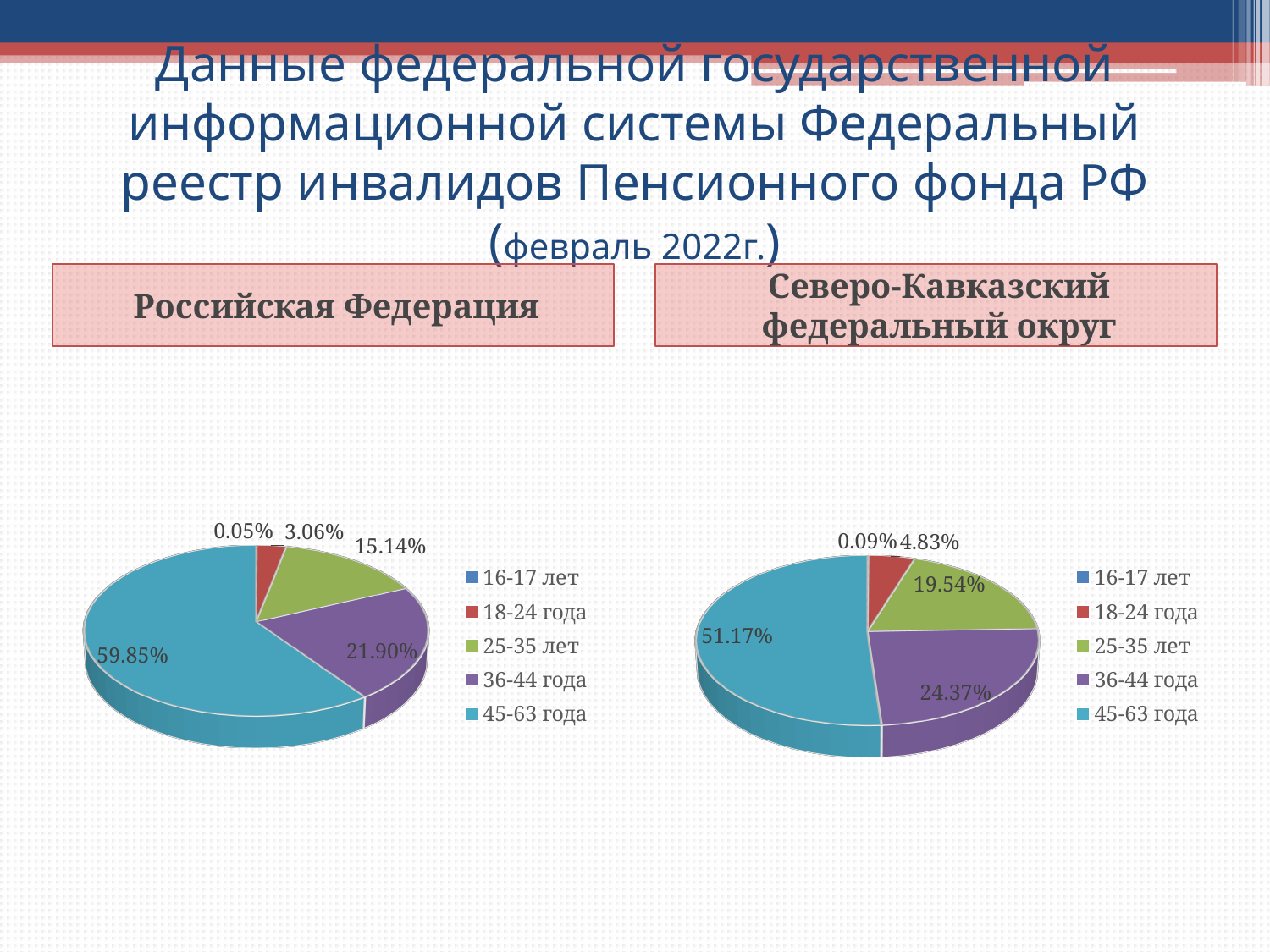
Which is larger: the 36-44 года share in the "Российская Федерация" chart or the 36-44 года share in the "Северо-Кавказский федеральный округ" chart? Северо-Кавказский федеральный округ In the "Северо-Кавказский федеральный округ" pie chart, what share is shown for the 36-44 года slice? 24.37% In the "Российская Федерация" pie chart, what value is labelled for the 25-35 лет slice? 15.14% In the "Российская Федерация" pie chart, which age group has the largest slice? 45-63 года In the "Северо-Кавказский федеральный округ" pie chart, what value is labelled for the 18-24 года slice? 4.83% What is the difference between the 45-63 года share in the "Российская Федерация" chart and the 45-63 года share in the "Северо-Кавказский федеральный округ" chart? 8.68% What type of chart is used under the heading "Северо-Кавказский федеральный округ"? Pie chart In the "Российская Федерация" pie chart, what share is shown for the 45-63 года slice? 59.85% In the "Северо-Кавказский федеральный округ" pie chart, what is the difference between the 36-44 года and 25-35 лет shares? 4.83% How many age groups does the legend of the "Российская Федерация" pie chart list? 5 In the "Российская Федерация" pie chart, which colour represents the 25-35 лет slice? Green In the "Северо-Кавказский федеральный округ" pie chart, which age group has the smallest slice? 16-17 лет